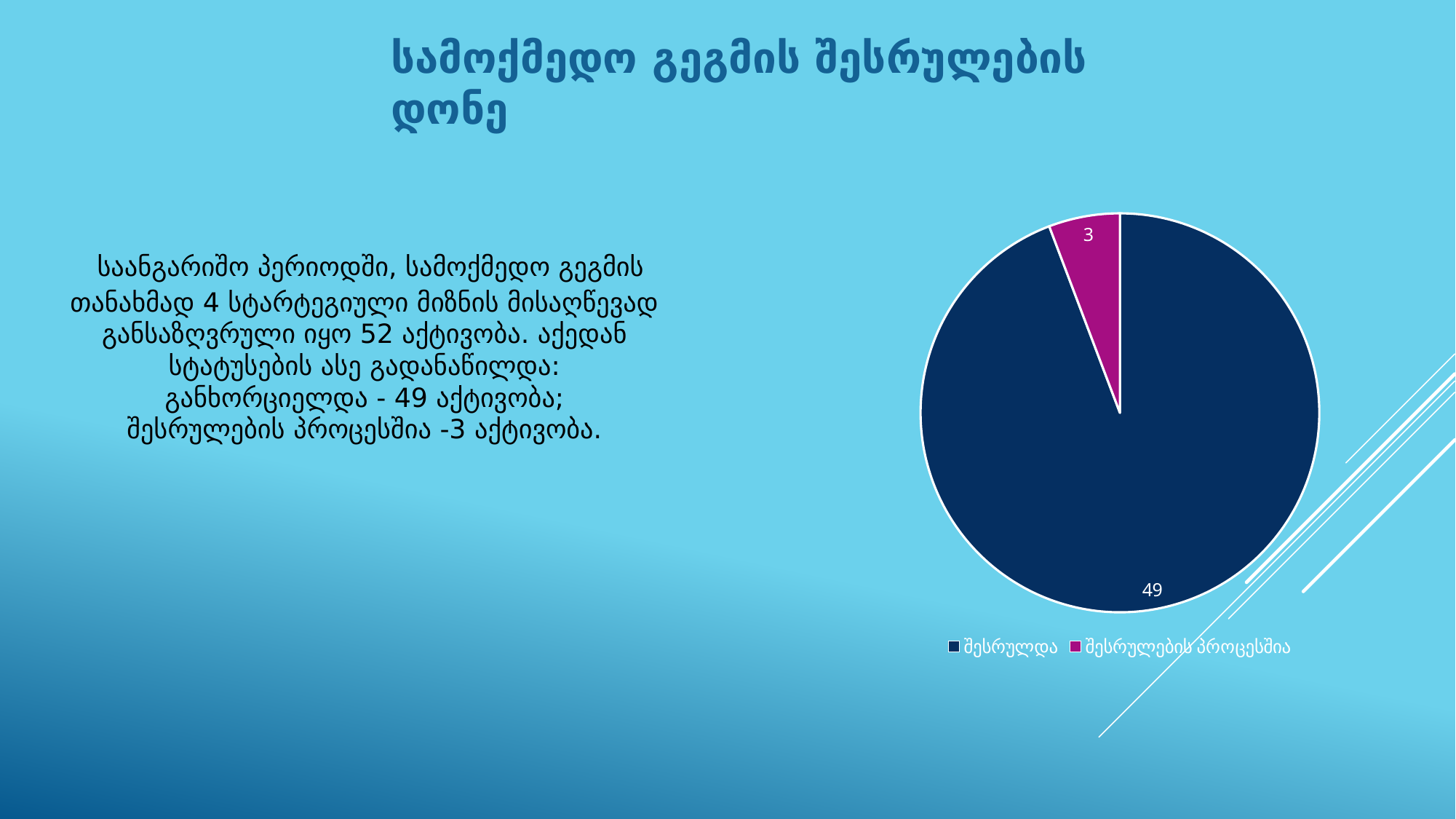
What is the difference between the შესრულდა and შესრულების პროცესშია values in the pie chart? 46 What is the value of the შესრულდა slice in the pie chart? 49 Which is larger in the pie chart, შესრულდა or შესრულების პროცესშია? შესრულდა What kind of chart is shown on the slide? pie chart What is the value of the შესრულების პროცესშია slice in the pie chart? 3 Which slice of the pie chart is the smallest? შესრულების პროცესშია What share of the pie chart total does the შესრულების პროცესშია slice represent? 3 out of 52 How many entries does the pie chart legend list? 2 What colour is the შესრულების პროცესშია slice in the pie chart? magenta/purple What is the total of all slices in the pie chart? 52 Which slice of the pie chart is the largest? შესრულდა How many slices does the pie chart have? 2